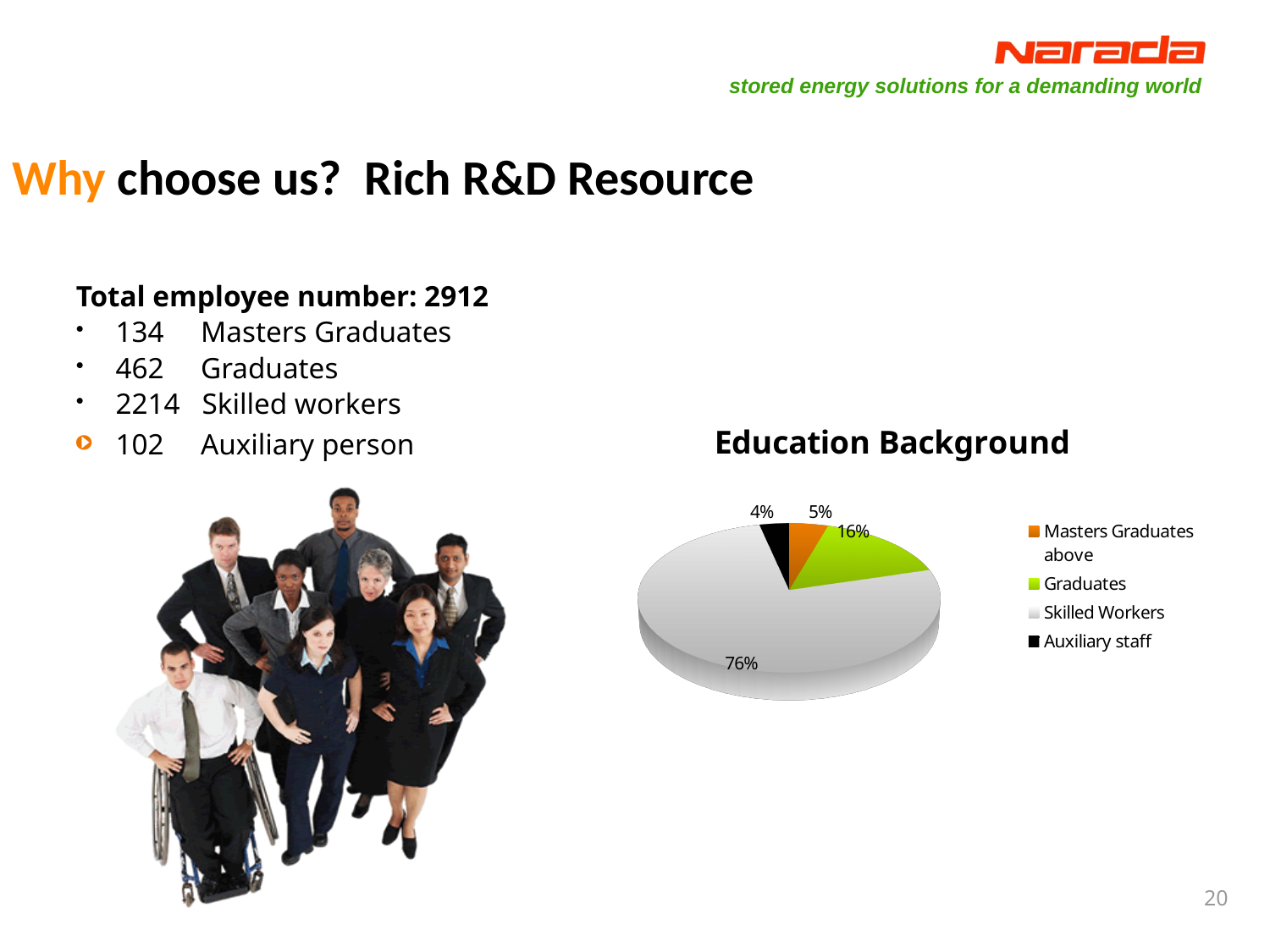
What share of the pie does Skilled Workers represent? 76% What is the difference in percentage points between the Skilled Workers slice and the Graduates slice? 60 What is the title of the pie chart? Education Background Which colour represents Skilled Workers in the pie chart legend? grey What share of the pie does Auxiliary staff represent? 4% Which slice is larger, Graduates or Masters Graduates above? Graduates Which category has the largest slice of the pie? Skilled Workers Which category has the smallest slice of the pie? Auxiliary staff How many categories does the pie chart show? 4 What type of chart is shown under the title "Education Background"? pie chart What share of the pie does Masters Graduates above represent? 5%